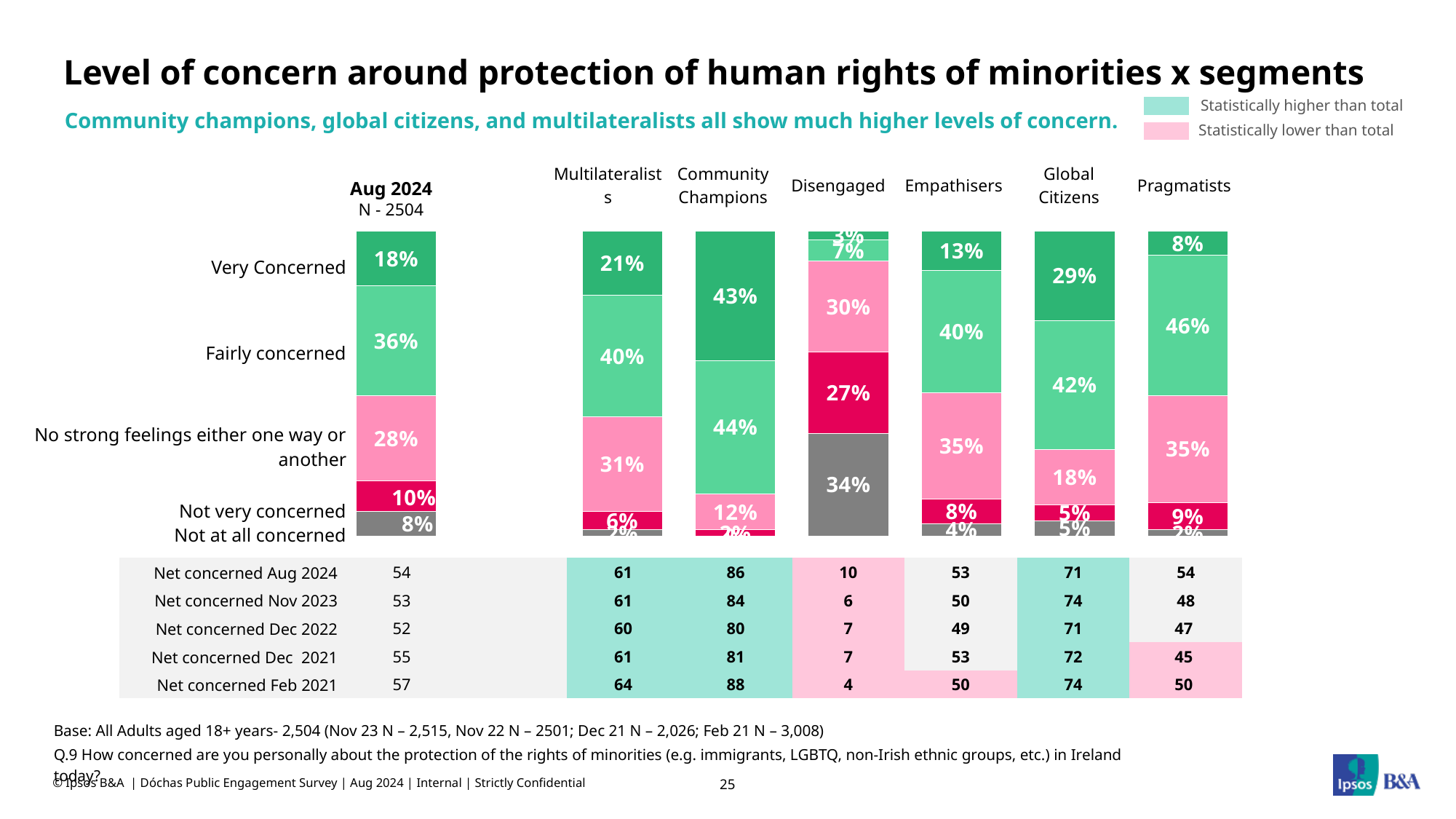
Which segment has the lowest share of Very Concerned respondents? Disengaged What is the difference between the Very Concerned share for Global Citizens and for Empathisers? 16 percentage points What percentage of the Disengaged segment has no strong feelings either one way or another? 30% What percentage of Pragmatists are Fairly concerned? 46% What is the Net concerned Aug 2024 value for Community Champions? 86 What percentage of the Aug 2024 total sample is Very Concerned? 18% According to the legend, what does the pink shading indicate? Statistically lower than total Which is larger: the Fairly concerned share for Multilateralists or for Global Citizens? Global Citizens What kind of chart is used to show the level of concern by segment? Stacked bar chart Which segment has the highest share of Very Concerned respondents? Community Champions How many segment bars are shown in the chart, including the Aug 2024 total? 7 What percentage of Community Champions are Very Concerned? 43%